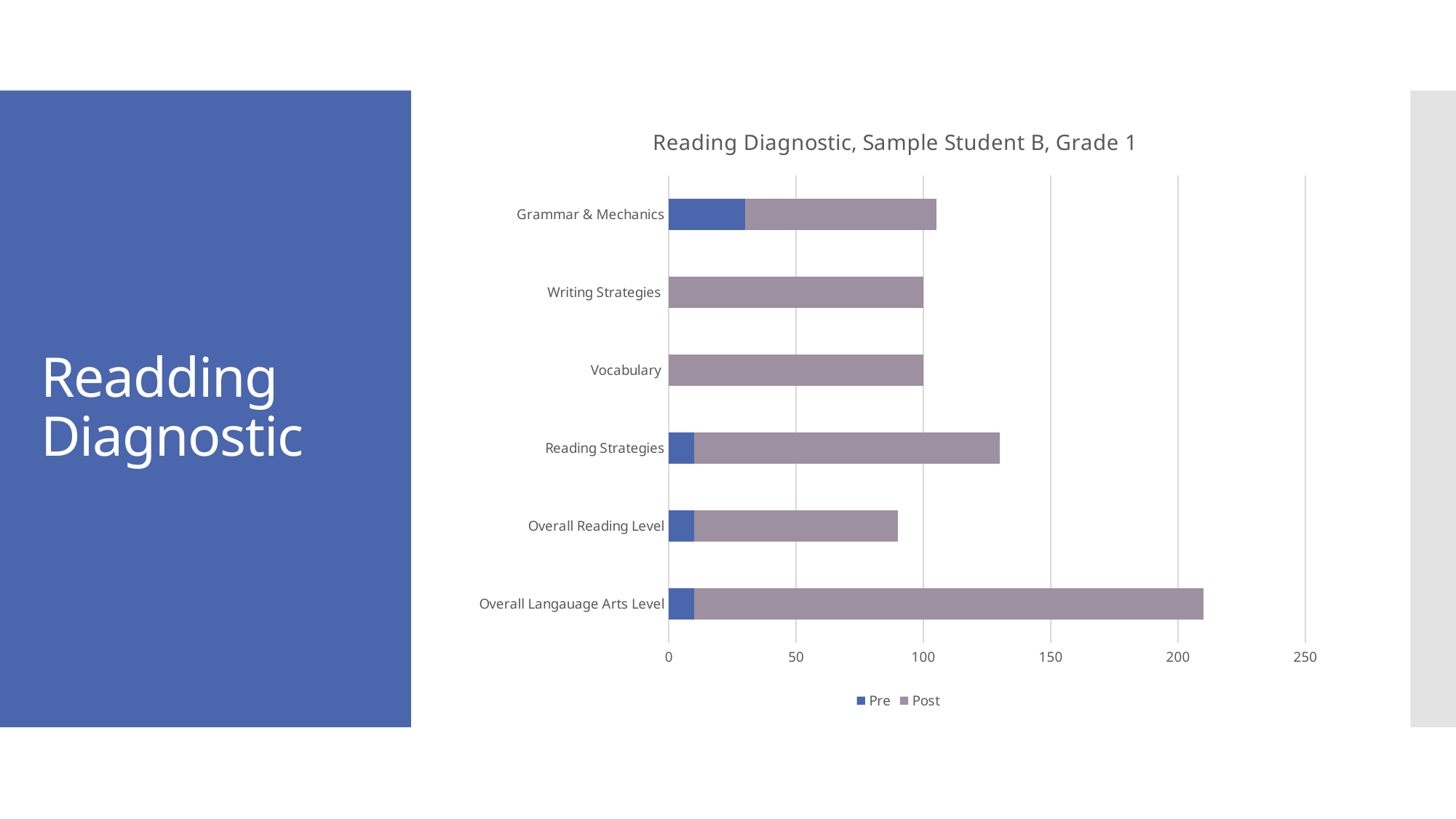
How many series does the legend list? 2 How many categories are plotted on the chart? 6 Which category has the longest total bar? Overall Langauage Arts Level What kind of chart is shown on the slide? bar chart Is the total bar for Overall Reading Level greater or less than 100? less Which category has the shortest total bar? Overall Reading Level Is the Pre value for Grammar & Mechanics greater or less than 50? less What are the two series named in the legend? Pre and Post Which has the larger Pre value, Grammar & Mechanics or Reading Strategies? Grammar & Mechanics What is the title of the chart? Reading Diagnostic, Sample Student B, Grade 1 Which has the longer total bar, Reading Strategies or Grammar & Mechanics? Reading Strategies Is the total bar for Overall Langauage Arts Level greater or less than 200? greater